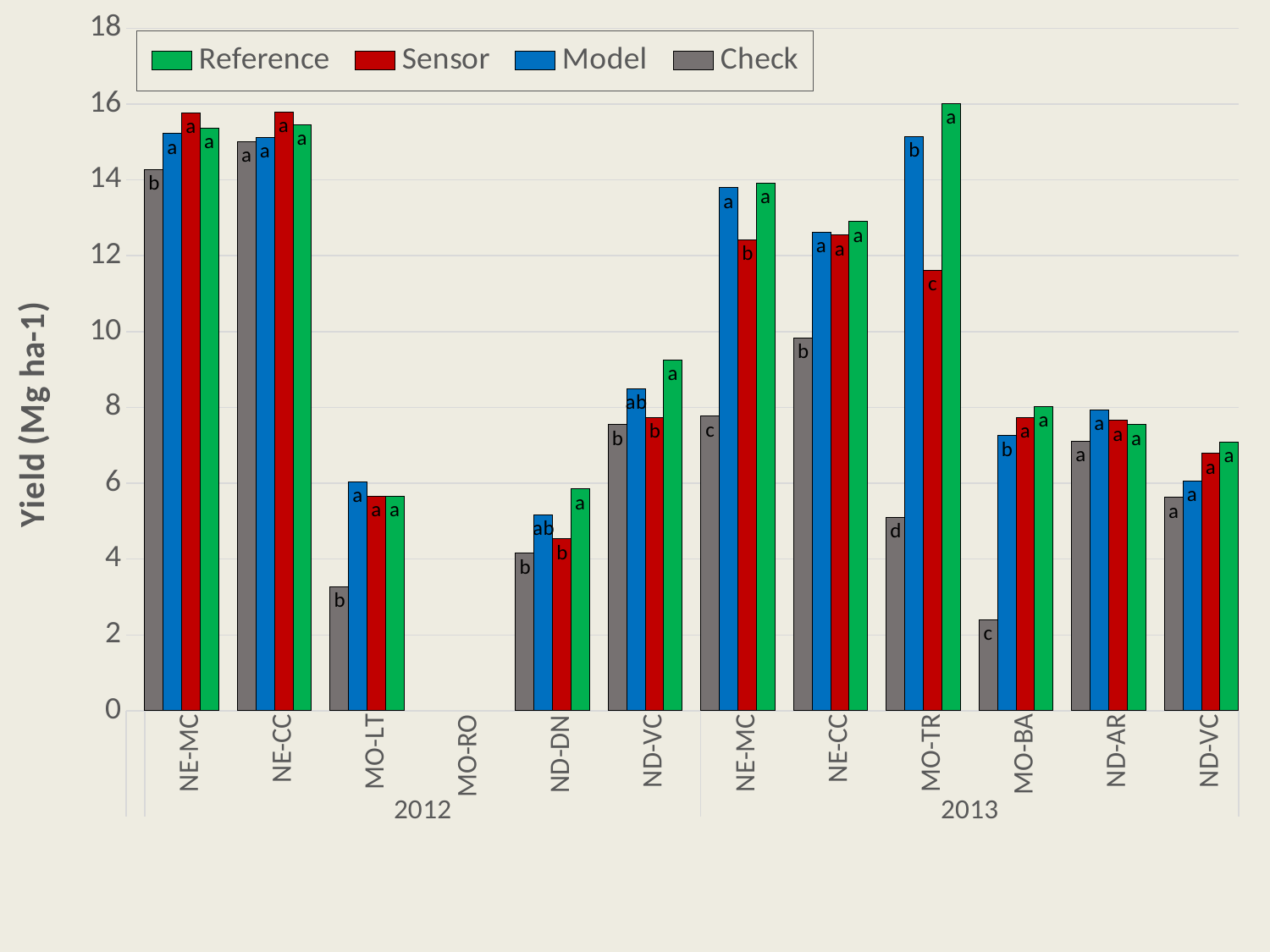
For MO-TR in 2013, which series has the highest value? Reference Is the Reference value for MO-TR in 2013 greater or less than 14? greater How many site labels are shown along the x axis? 12 For MO-TR in 2013, which is larger, the Model value or the Sensor value? Model Is the Reference value for ND-VC in 2012 greater or less than 8? greater What kind of chart is shown on the slide? bar chart How many series does the legend list? 4 Is the Check value for MO-BA in 2013 greater or less than 4? less For MO-BA in 2013, which is larger, the Check value or the Reference value? Reference What is the title of the y axis? Yield (Mg ha-1) Across all sites, which site has the lowest Check value? MO-BA (2013)